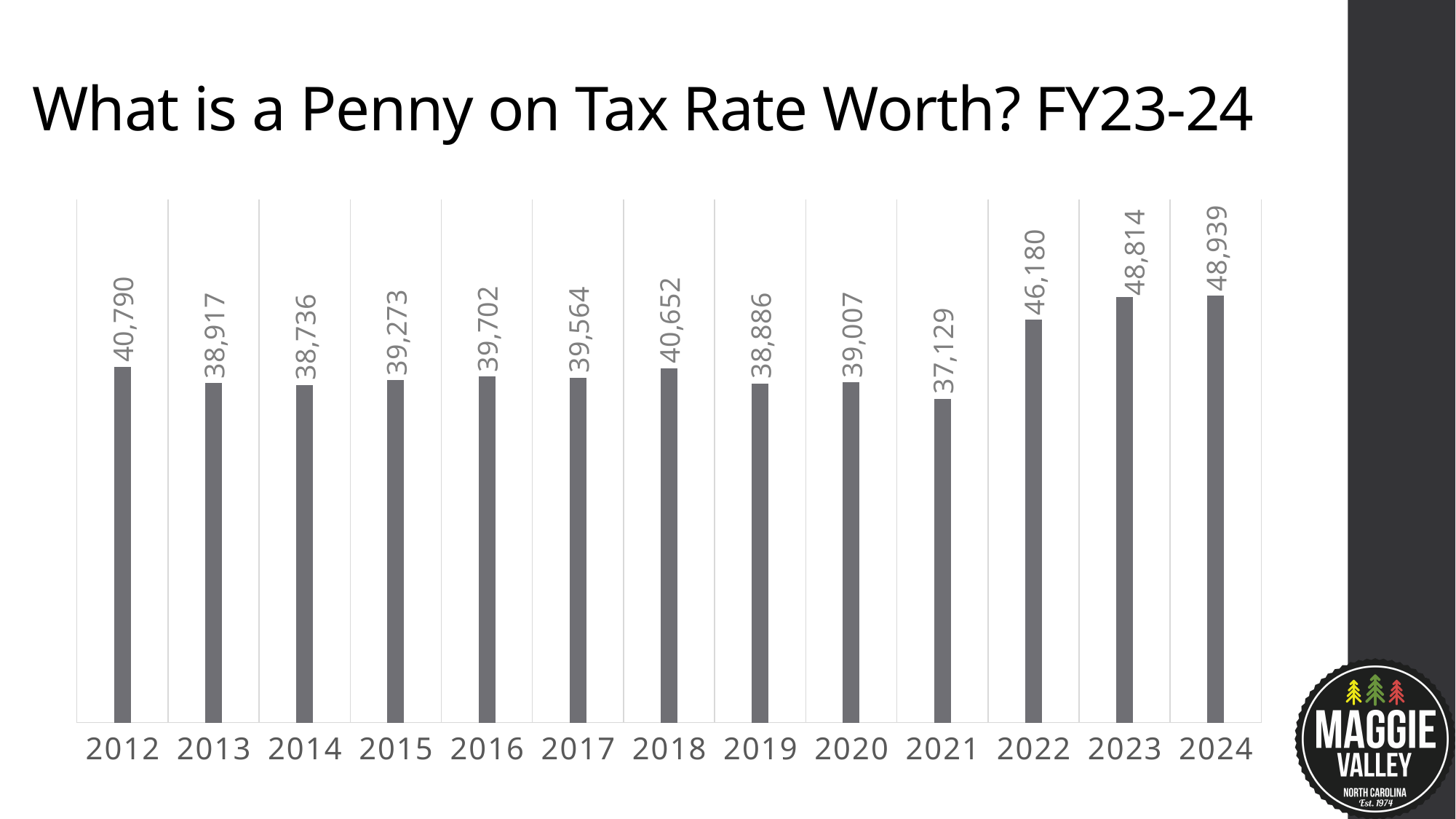
What is the value for 2024? 48,939 What is the title of the slide? What is a Penny on Tax Rate Worth? FY23-24 Which is larger, the value for 2012 or the value for 2020? 2012 What kind of chart is shown on the slide? bar chart What is the value for 2018? 40,652 What is the value for 2021? 37,129 What is the difference between the values for 2024 and 2021? 11,810 Which year has the highest value? 2024 Which year has the lowest value? 2021 How many years are shown on the x axis? 13 What is the value for 2012? 40,790 What is the difference between the values for 2023 and 2022? 2,634